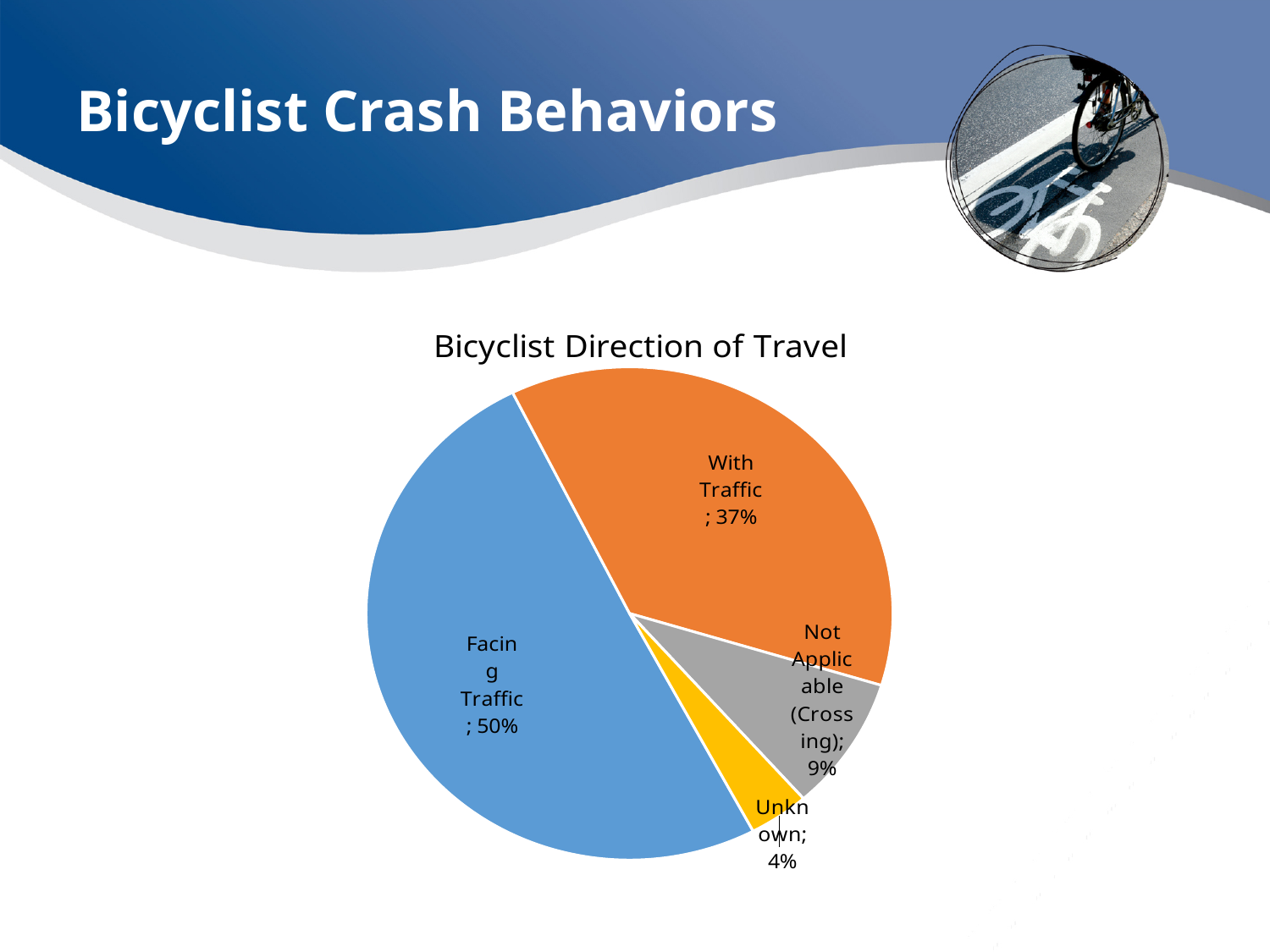
What is the difference in percentage points between Facing Traffic and With Traffic? 13 What colour is the Unknown slice? Yellow Which category has the largest slice of the pie? Facing Traffic Which category has the smallest slice of the pie? Unknown How many categories are shown in the pie chart? 4 What share of the pie does Facing Traffic represent? 50% What share of the pie does With Traffic represent? 37% What is the title of the chart? Bicyclist Direction of Travel What share of the pie does Unknown represent? 4% What kind of chart is shown on the slide? Pie chart What share of the pie does Not Applicable (Crossing) represent? 9% Which is larger, the share for With Traffic or the share for Not Applicable (Crossing)? With Traffic